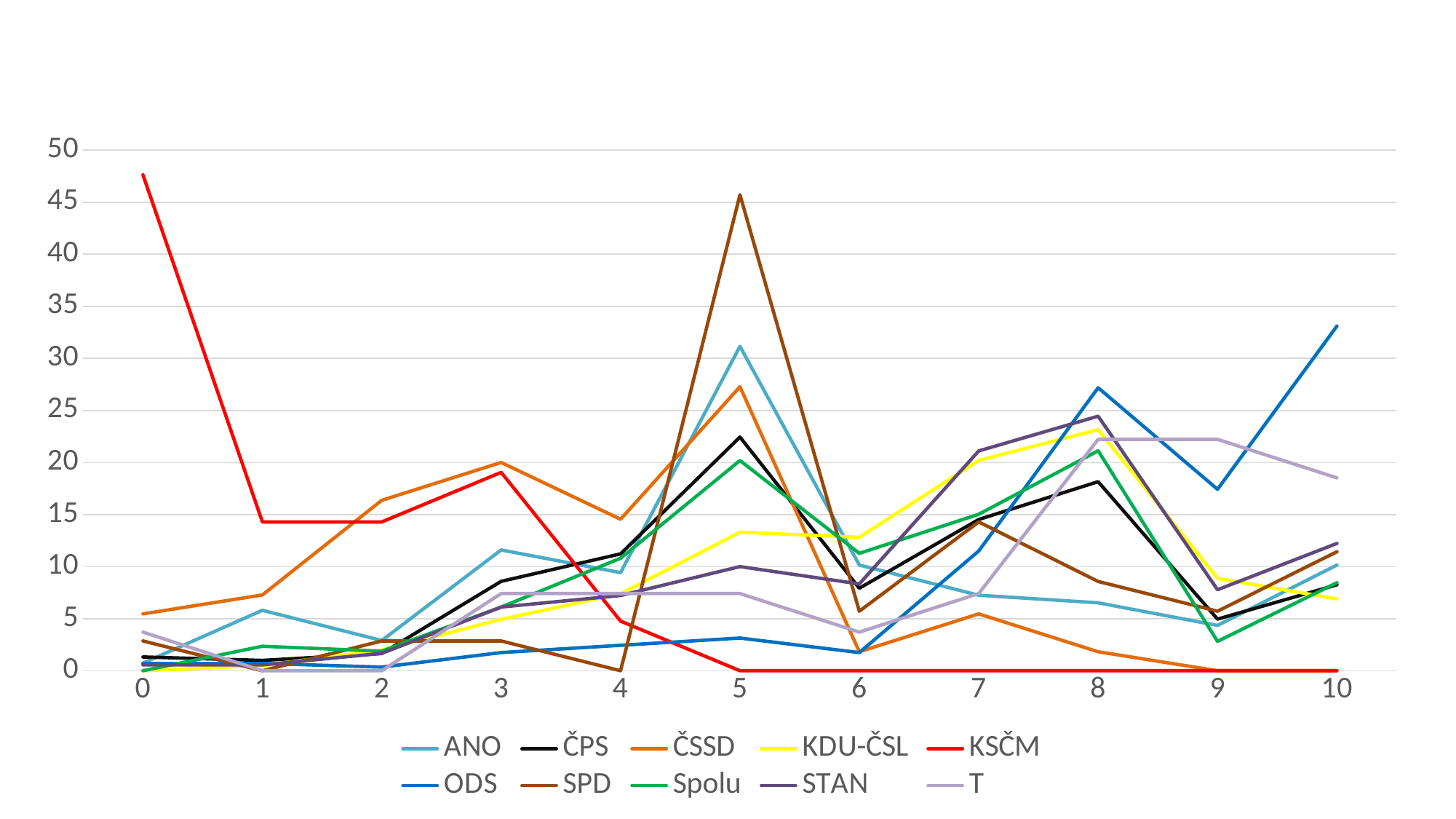
Which series has the highest value at x = 0? KSČM How many series does the legend list? 10 Which series has the highest value at x = 10? ODS At x = 8, which is larger, ODS or SPD? ODS Is the value for ODS at x = 10 greater or less than 30? greater At x = 5, which is larger, SPD or ANO? SPD How many points are there along the x axis? 11 Is the value for SPD at x = 5 greater or less than 40? greater Is the value for ANO at x = 5 greater or less than 25? greater What kind of chart is shown on the slide? line chart